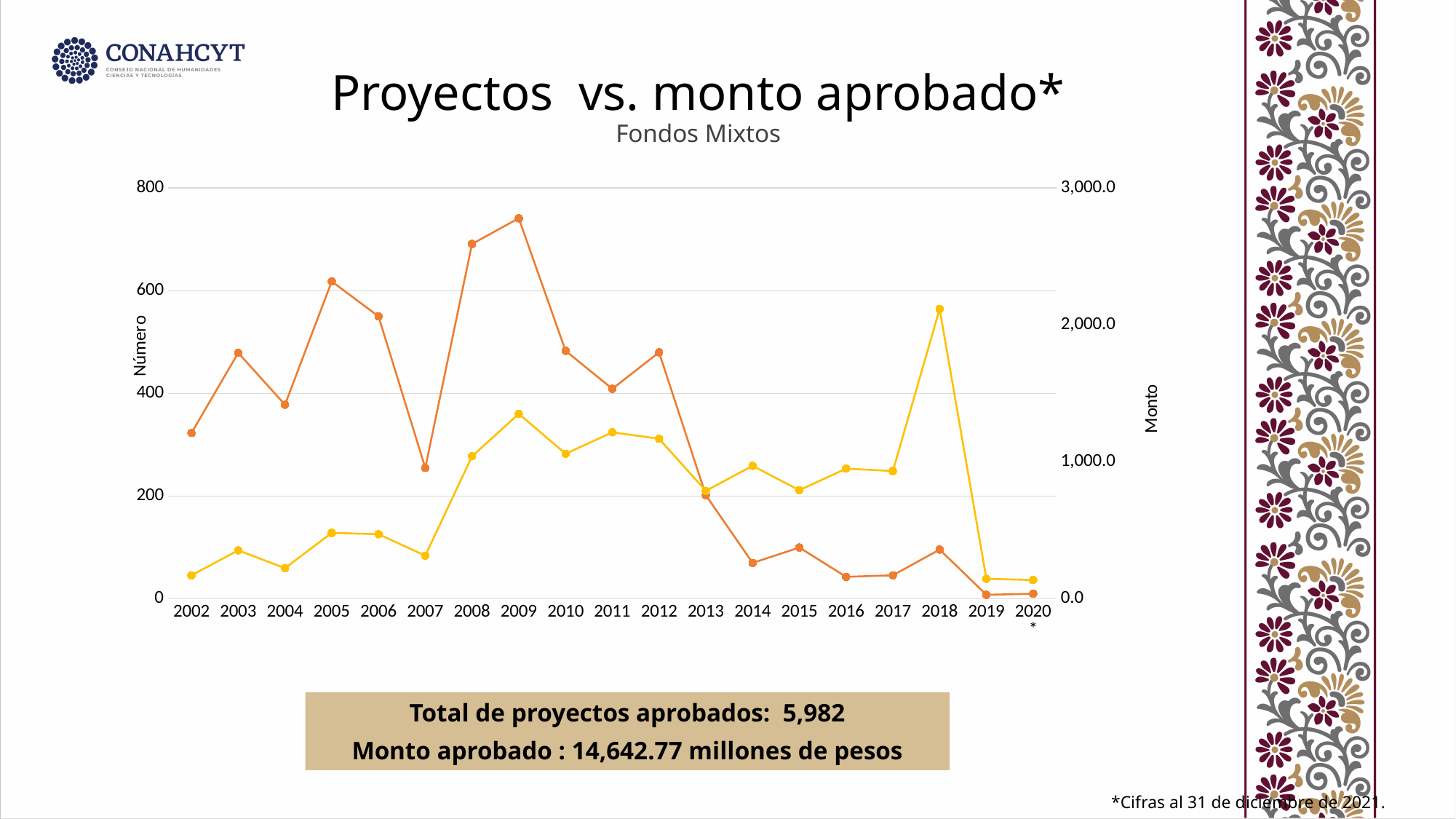
On the orange line (Número), which year has the higher value, 2005 or 2006? 2005 What is the label of the left vertical axis of the chart? Número Is the value of the yellow line (Monto) for 2018 greater or less than 1,000.0? greater What kind of chart is shown on the slide? Line chart Is the value of the yellow line (Monto) for 2002 greater or less than 1,000.0? less In which year does the yellow line (Monto) reach its highest point? 2018 In which year does the orange line (Número) reach its highest point? 2009 Does the orange line (Número) rise or fall from 2012 to 2019? Fall Is the value of the orange line (Número) for 2002 greater or less than 400? less How many years are plotted along the x axis of the chart? 19 In which year does the orange line (Número) reach its lowest point? 2019